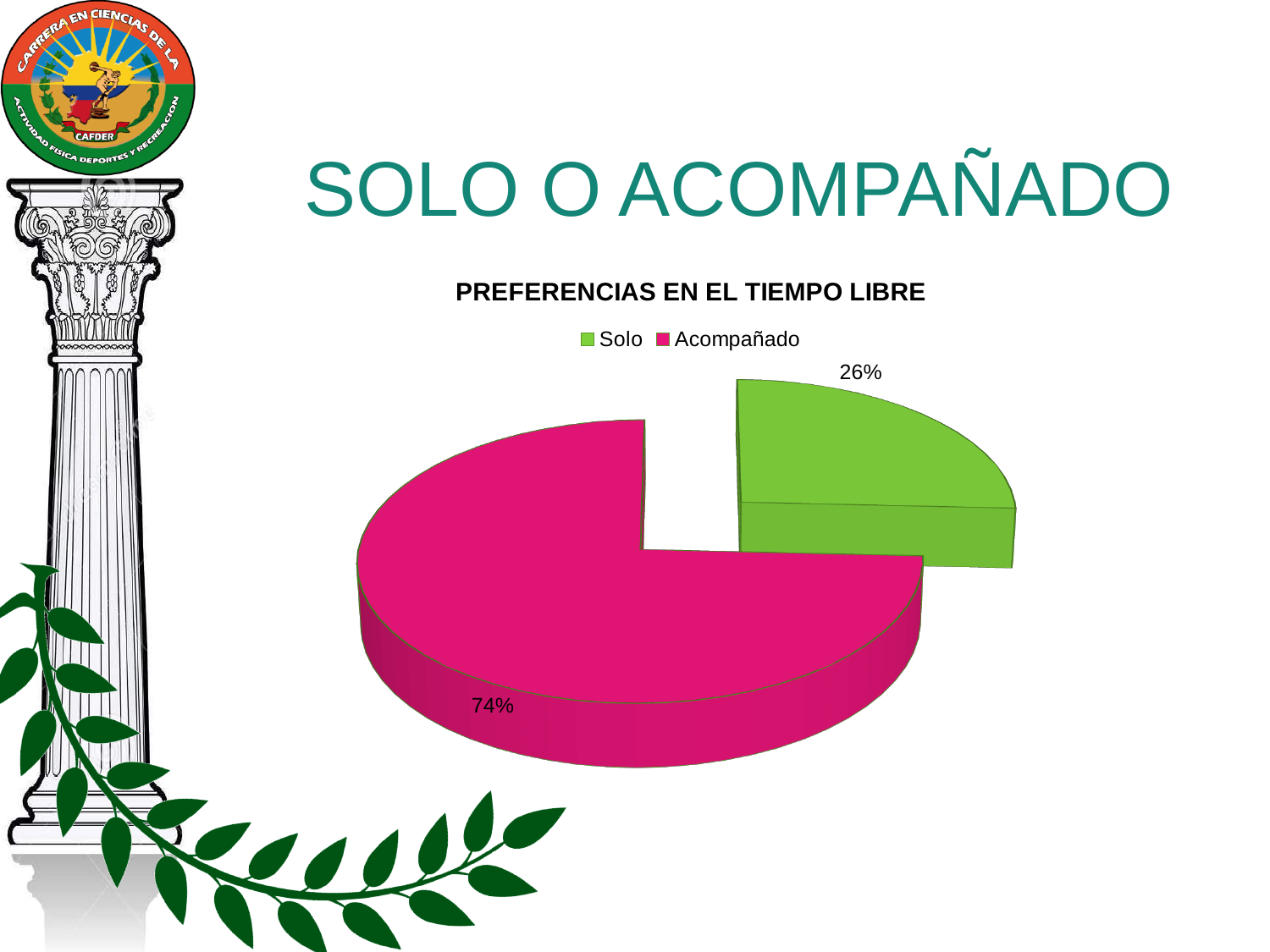
What percentage of the pie chart is labelled for Solo? 26% Which is larger, the share for Solo or the share for Acompañado? Acompañado What is the difference in percentage points between Acompañado and Solo? 48 What kind of chart is shown on the slide? Pie chart What is the share of the pie taken by the Solo slice? 26% Which category has the largest share of the pie chart? Acompañado Which category has the smallest share of the pie chart? Solo What colour is the Acompañado slice in the pie chart? Pink What is the title of the chart? PREFERENCIAS EN EL TIEMPO LIBRE How many entries does the legend list? 2 What percentage of the pie chart is labelled for Acompañado? 74% How many categories does the pie chart show? 2